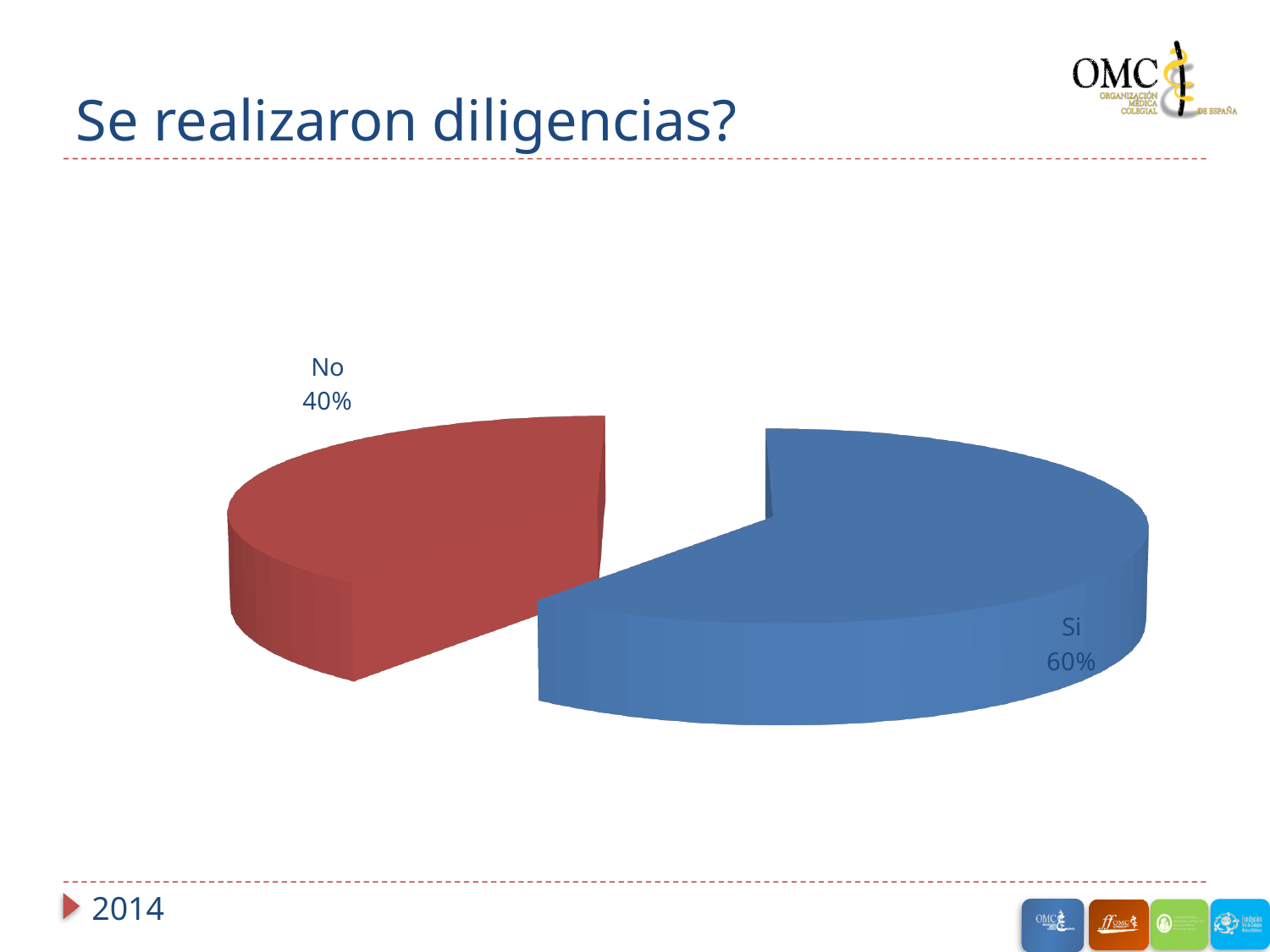
Which is larger, the "Si" slice or the "No" slice? Si What is the difference in percentage points between the "Si" and "No" slices? 20 What colour is the "Si" slice? blue Which slice is the smallest? No What is the title of the slide containing the chart? Se realizaron diligencias? What share of the pie does the "No" slice take? 40% Which slice is the largest? Si How many slices does the pie chart have? 2 What percentage does the "Si" slice represent? 60% What percentage does the "No" slice represent? 40% What kind of chart is shown on the slide? pie chart